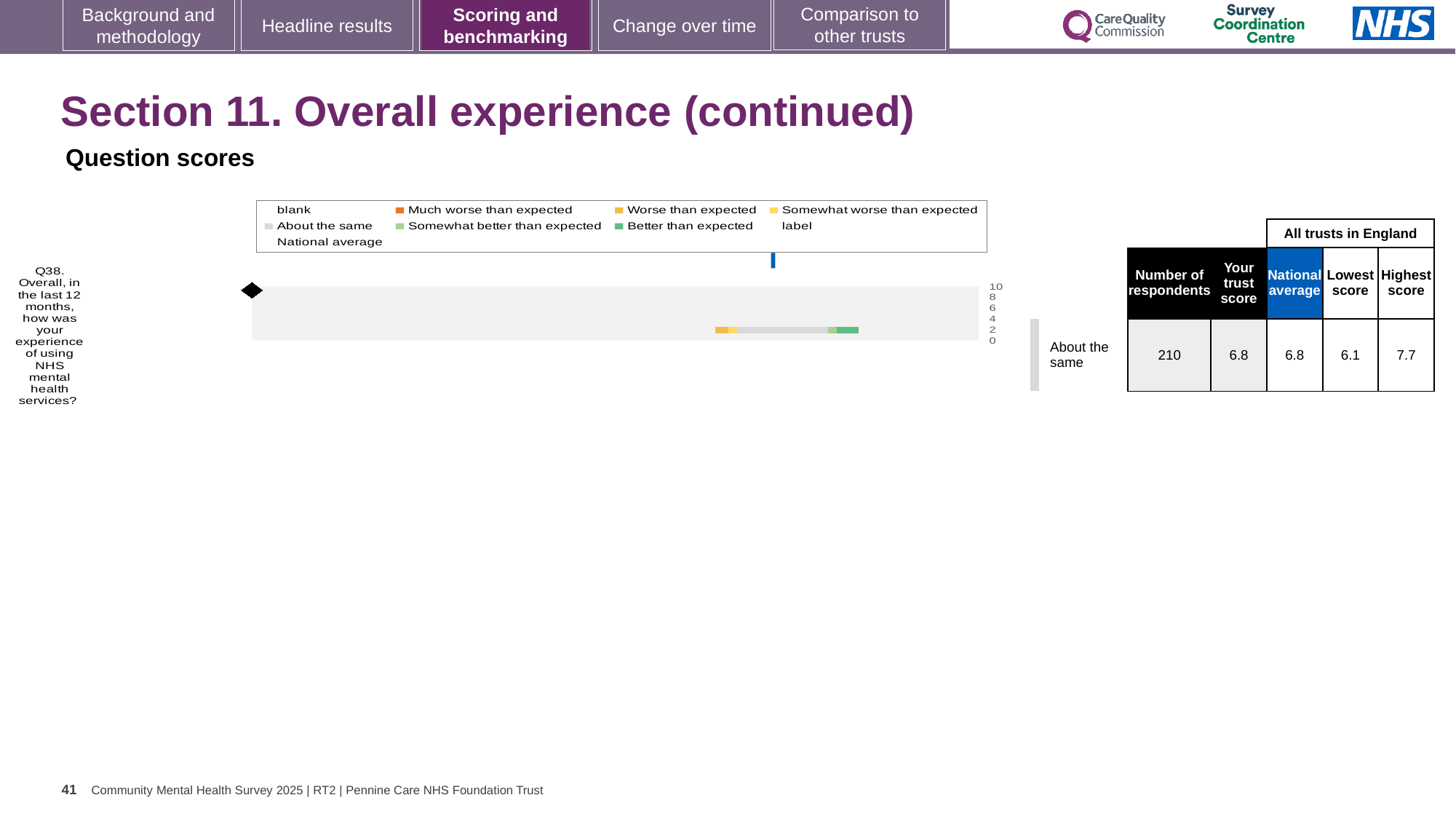
What is the trust score for Q38 shown in the table beside the chart? 6.8 What is the number of respondents for Q38 shown in the table beside the chart? 210 What is the lowest score across all trusts in England for Q38? 6.1 What is the highest value shown on the chart's axis? 10 What is the national average for Q38 shown in the table beside the chart? 6.8 What colour does the legend use for 'Better than expected'? green What is the highest score across all trusts in England for Q38? 7.7 What is the difference between the highest score and the lowest score for Q38 across all trusts in England? 1.6 What benchmark category label is shown next to the chart for Q38? About the same Which question is plotted in the chart on this slide? Q38. Overall, in the last 12 months, how was your experience of using NHS mental health services? How many survey questions are plotted in the chart on this slide? 1 What kind of chart is shown for Q38 on this slide? bar chart